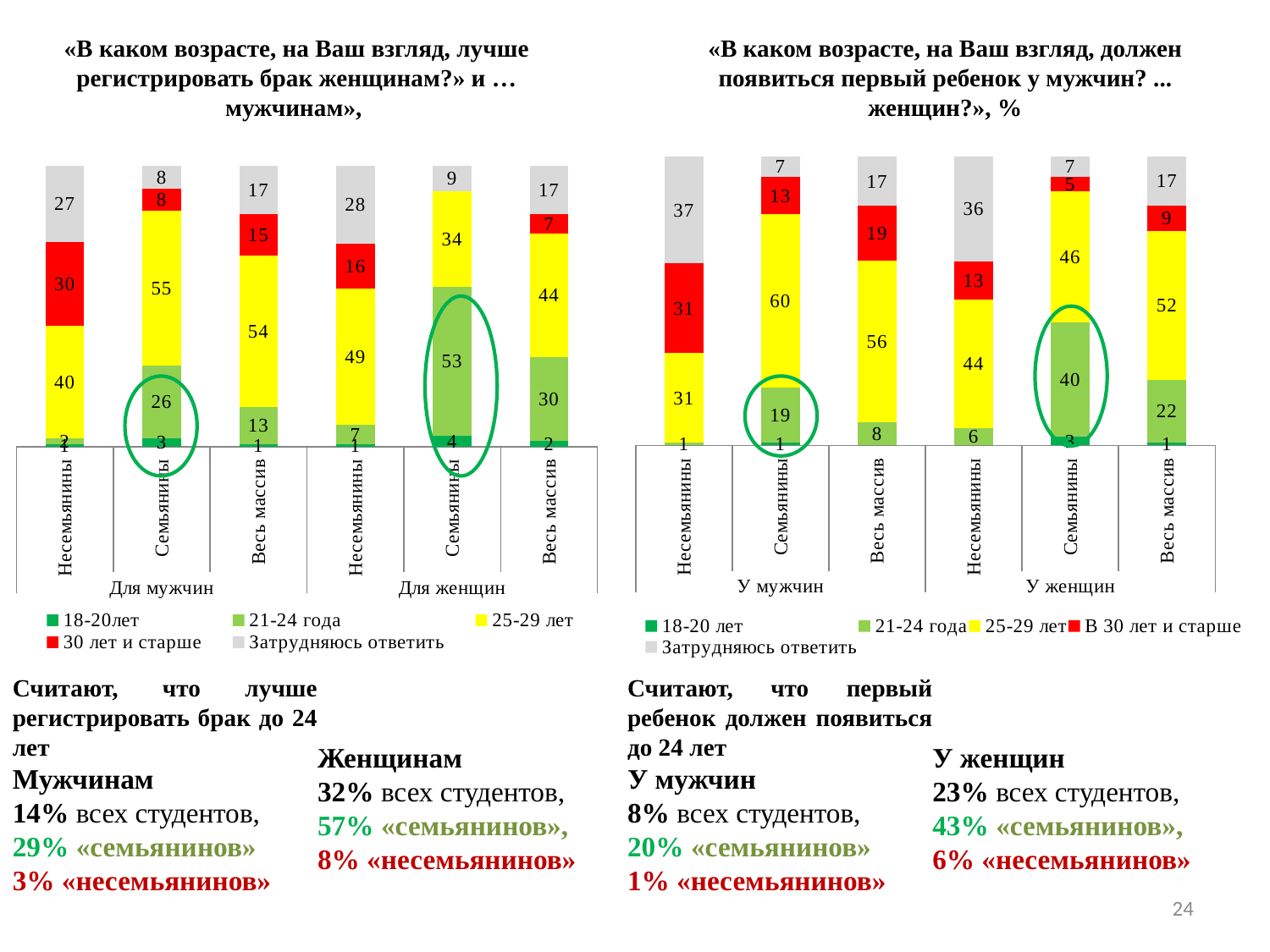
In the right chart (about the first child), which is larger: the 25-29 лет value for Весь массив in the У мужчин group or in the У женщин group? У мужчин In the left chart (about registering marriage), what is the value of the 21-24 года segment for Семьянины in the Для женщин group? 53 In the right chart (about the first child), what is the value of the В 30 лет и старше segment for Несемьянины in the У мужчин group? 31 What kind of chart is the right chart (about the first child)? Stacked bar chart In the right chart (about the first child), what is the value of the 21-24 года segment for Семьянины in the У женщин group? 40 How many series does the legend of the left chart list? 5 In the left chart (about registering marriage), which bar has the highest 21-24 года value? Семьянины (Для женщин) In the left chart (about registering marriage), what is the difference between the 21-24 года values for Семьянины in the Для женщин group and Семьянины in the Для мужчин group? 27 How many bars (categories) are shown in the left chart? 6 In the right chart (about the first child), what is the value of the 25-29 лет segment for Семьянины in the У мужчин group? 60 In the right chart (about the first child), what is the value of the Затрудняюсь ответить segment for Весь массив in the У женщин group? 17 In the left chart (about registering marriage), what is the value of the 25-29 лет segment for Семьянины in the Для мужчин group? 55